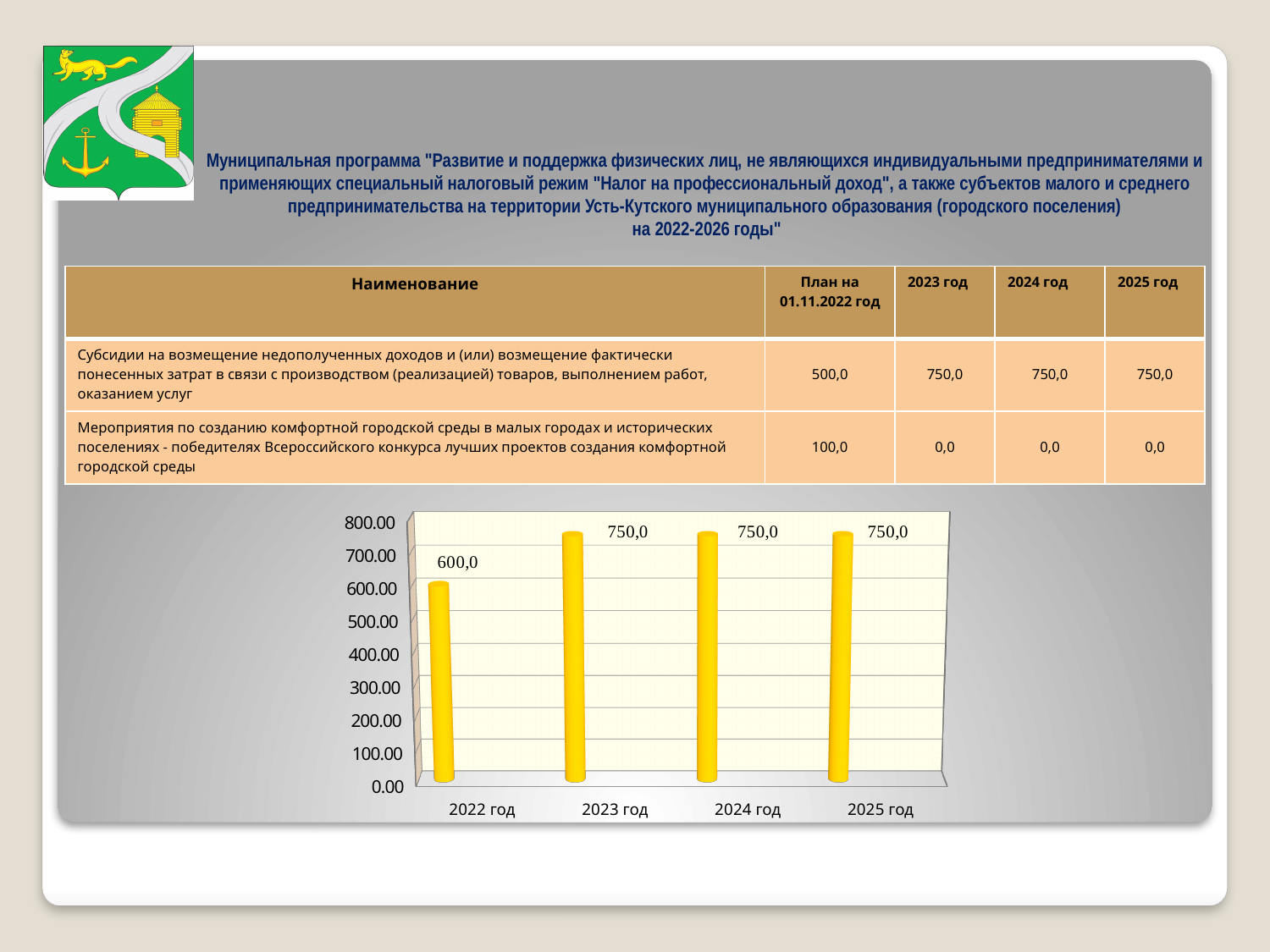
Which is larger in the chart, the value for 2022 год or the value for 2024 год? 2024 год Which year has the lowest value in the chart? 2022 год What is the value for 2023 год in the chart? 750,0 What is the difference between the values for 2023 год and 2022 год in the chart? 150,0 What is the value for 2025 год in the chart? 750,0 Do the values in the chart rise or fall from 2022 год to 2023 год? rise What is the value for 2022 год in the chart? 600,0 Is the value for 2022 год in the chart greater or less than 700.00? less Is the value for 2024 год in the chart greater or less than 700.00? greater What is the highest value shown on the y axis of the chart? 800.00 What kind of chart is shown on the slide? bar chart How many years are shown on the x axis of the chart? 4